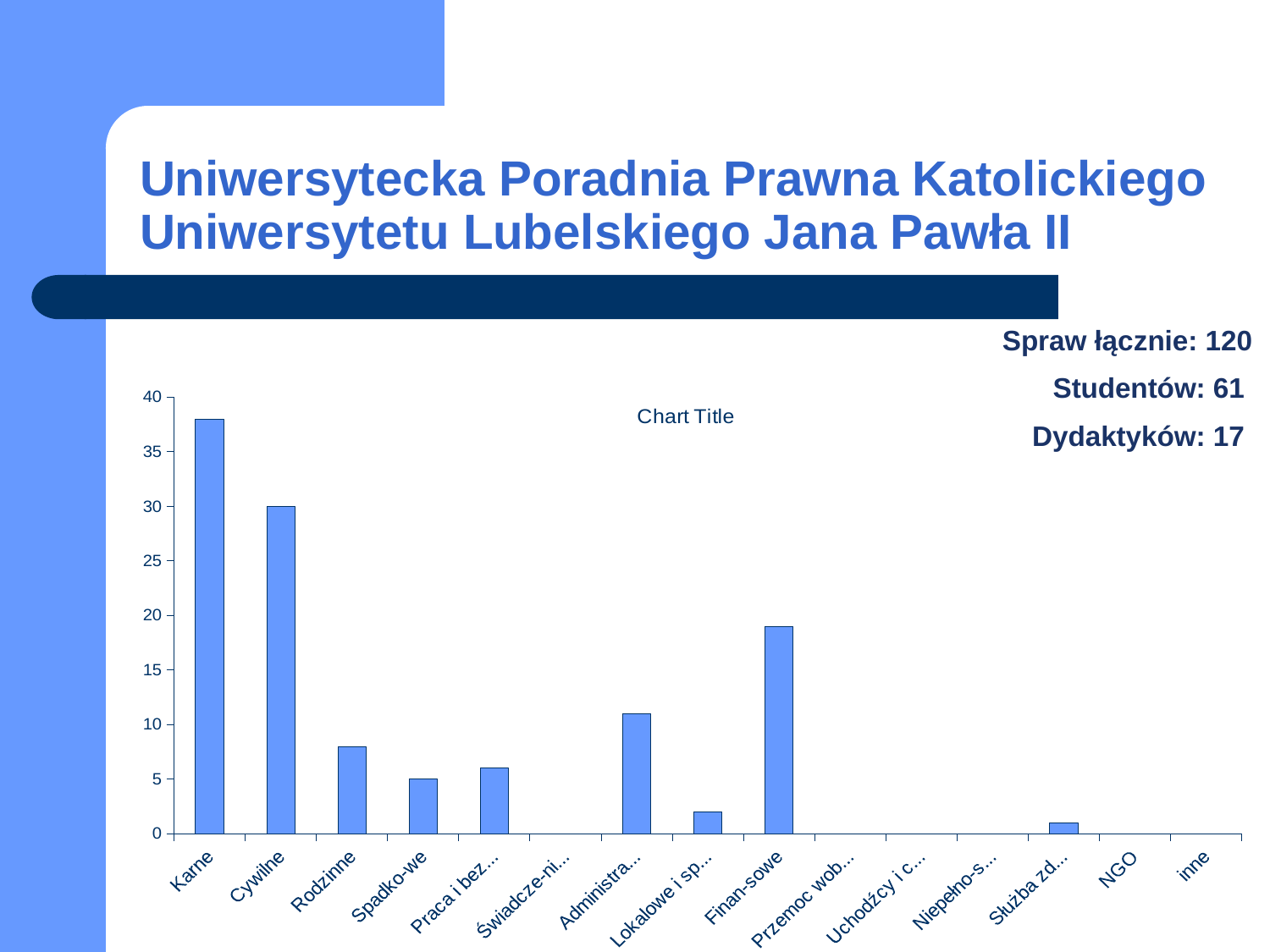
Is the value for Karne greater or less than 35? greater What kind of chart is shown on the slide? bar chart Is the value for Finan-sowe greater or less than 20? less Which is larger, the value for Karne or the value for Cywilne? Karne Which is larger, the value for Finan-sowe or the value for Administra...? Finan-sowe What is the value for Cywilne in the chart? 30 What is the title shown on the chart? Chart Title Is the value for Administra... greater or less than 10? greater How many categories are shown on the x axis of the chart? 15 Which category has the highest bar in the chart? Karne What is the value for Spadko-we in the chart? 5